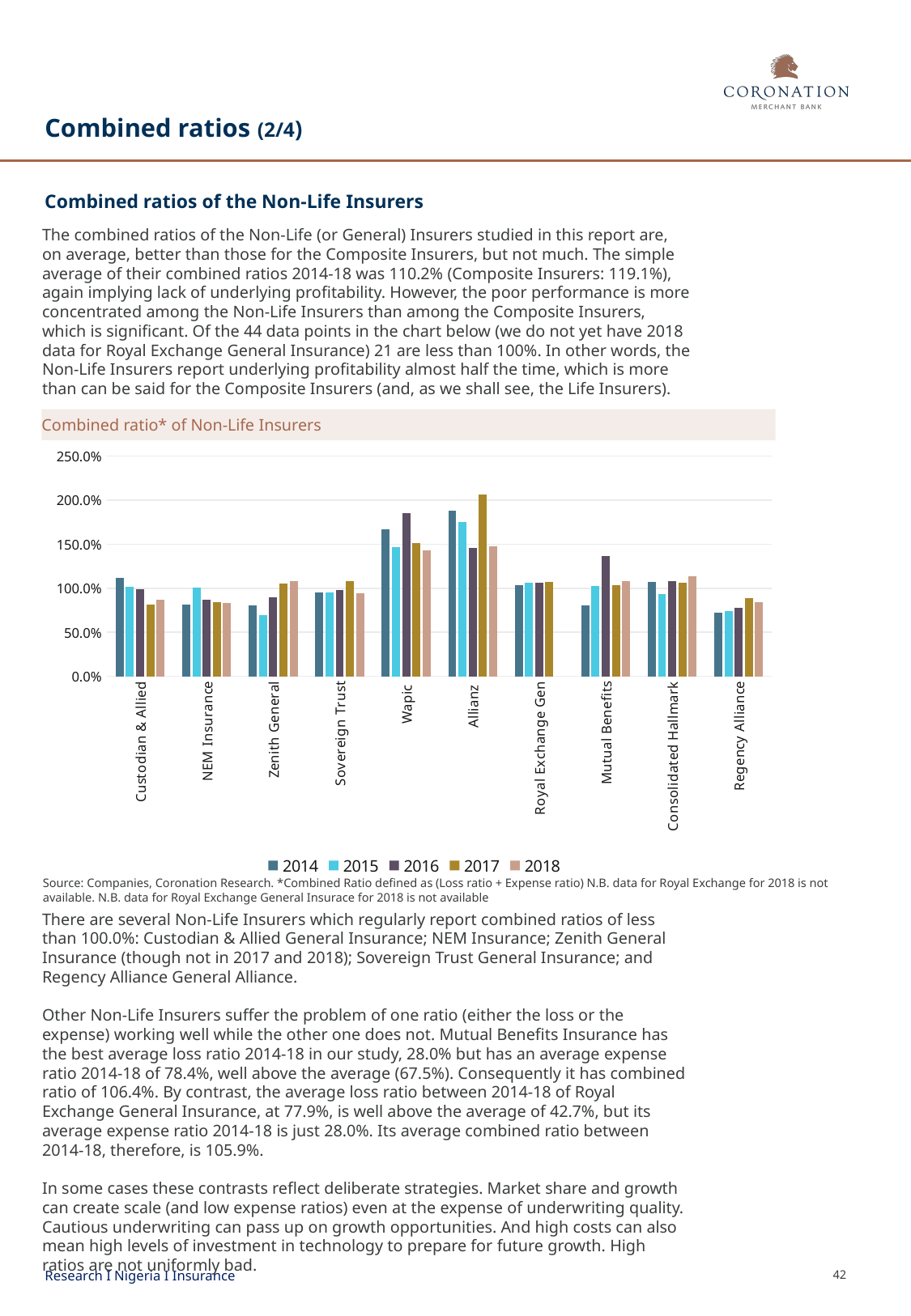
What kind of chart is shown on the slide? bar chart Is the 2015 value for Zenith General greater or less than 100.0%? less Is the 2017 value for Allianz greater or less than 200.0%? greater Is the 2016 value for Mutual Benefits greater or less than 100.0%? greater For Allianz, which year has the highest combined ratio? 2017 How many series does the chart legend list? 5 What is the title of the chart? Combined ratio* of Non-Life Insurers Which insurer has the tallest bar in the chart? Allianz How many insurers are shown on the x axis of the chart? 10 Which is larger for 2014: the value for Allianz or the value for Wapic? Allianz Which insurer has no bar for 2018 in the chart? Royal Exchange Gen